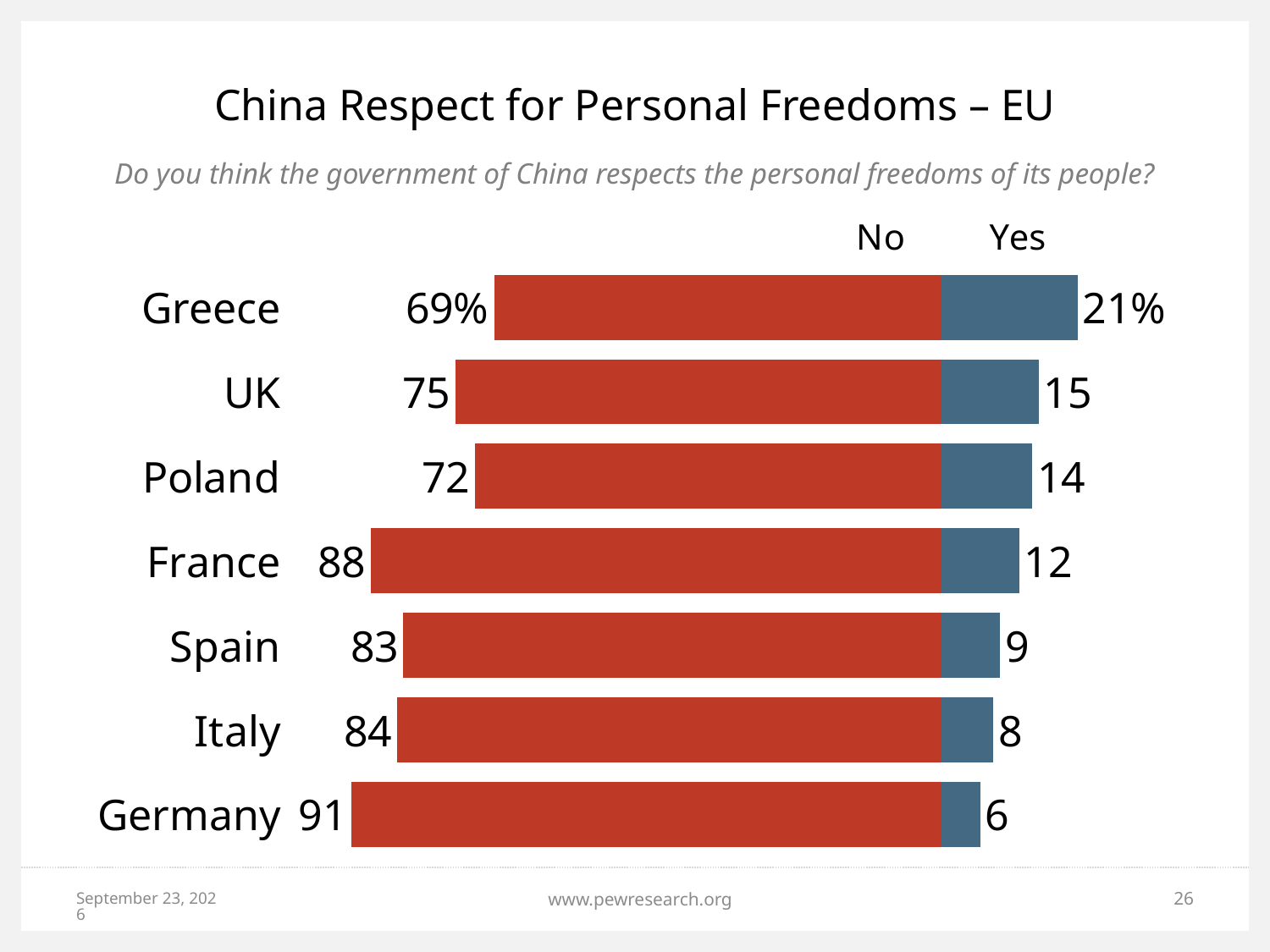
Which is larger, the "Yes" value for Spain or the "Yes" value for Italy? Spain Which colour represents the "No" responses? Red What is the difference between the "No" values for France and the UK? 13 What percentage of respondents in Greece answered "No"? 69% What is the "Yes" value for Poland? 14 How many series does the chart show? 2 Which country has the highest "No" value? Germany What type of chart is shown on the slide? Bar chart Which country has the lowest "Yes" value? Germany Which country has the highest "Yes" value? Greece What is the "No" value for Germany? 91 How many countries are shown in the chart? 7